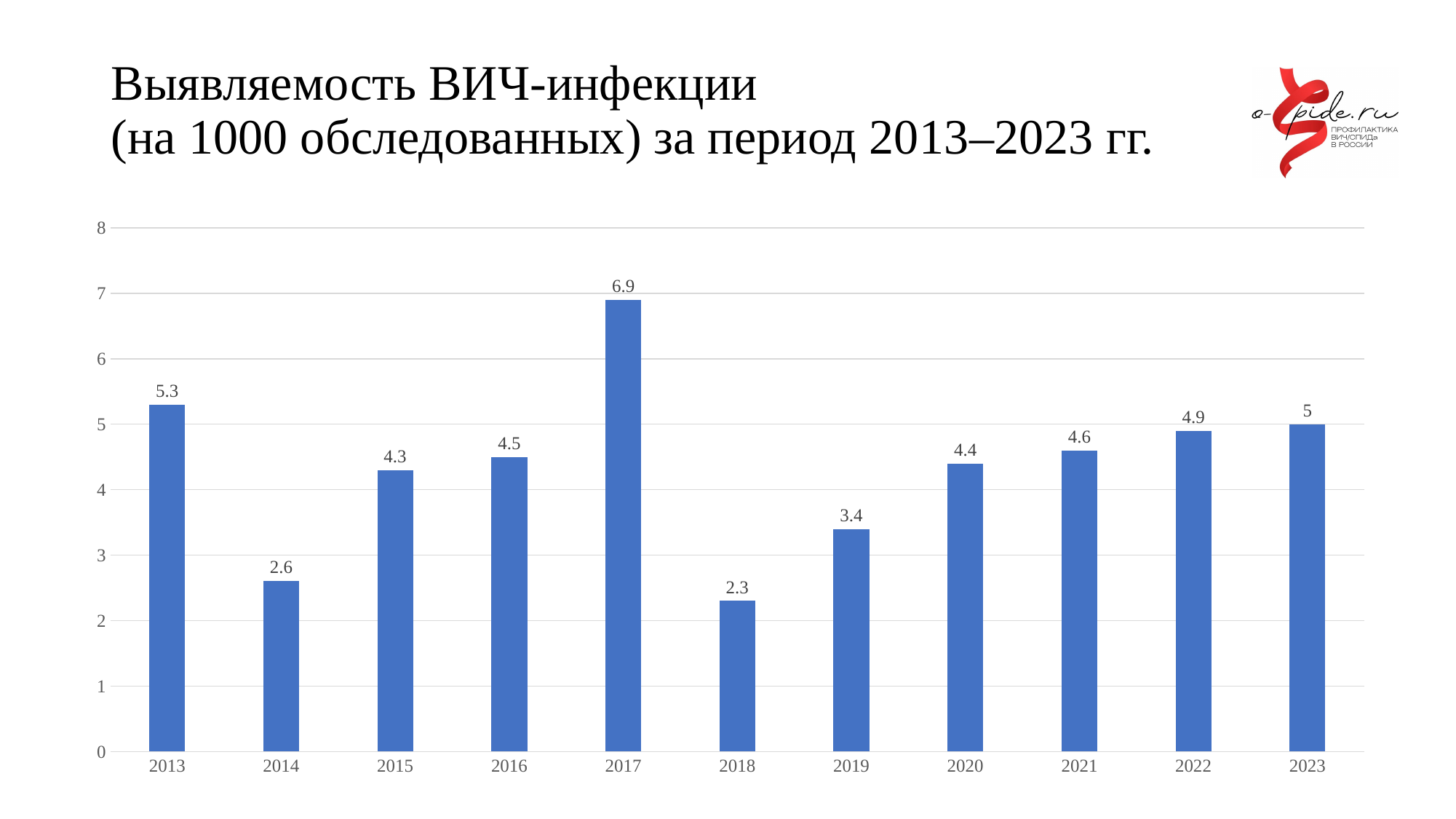
How many years are shown on the x axis? 11 Do the values rise or fall from 2018 to 2023? rise What is the difference between the values for 2017 and 2018? 4.6 Which year has the lowest value? 2018 What is the value for 2014? 2.6 What is the value for 2017? 6.9 Is the value for 2019 greater or less than 4? less Which is larger, the value for 2013 or the value for 2022? 2013 What is the value for 2023? 5 What kind of chart is shown on the slide? bar chart What is the title of the chart? Выявляемость ВИЧ-инфекции (на 1000 обследованных) за период 2013–2023 гг. Which year has the highest value? 2017